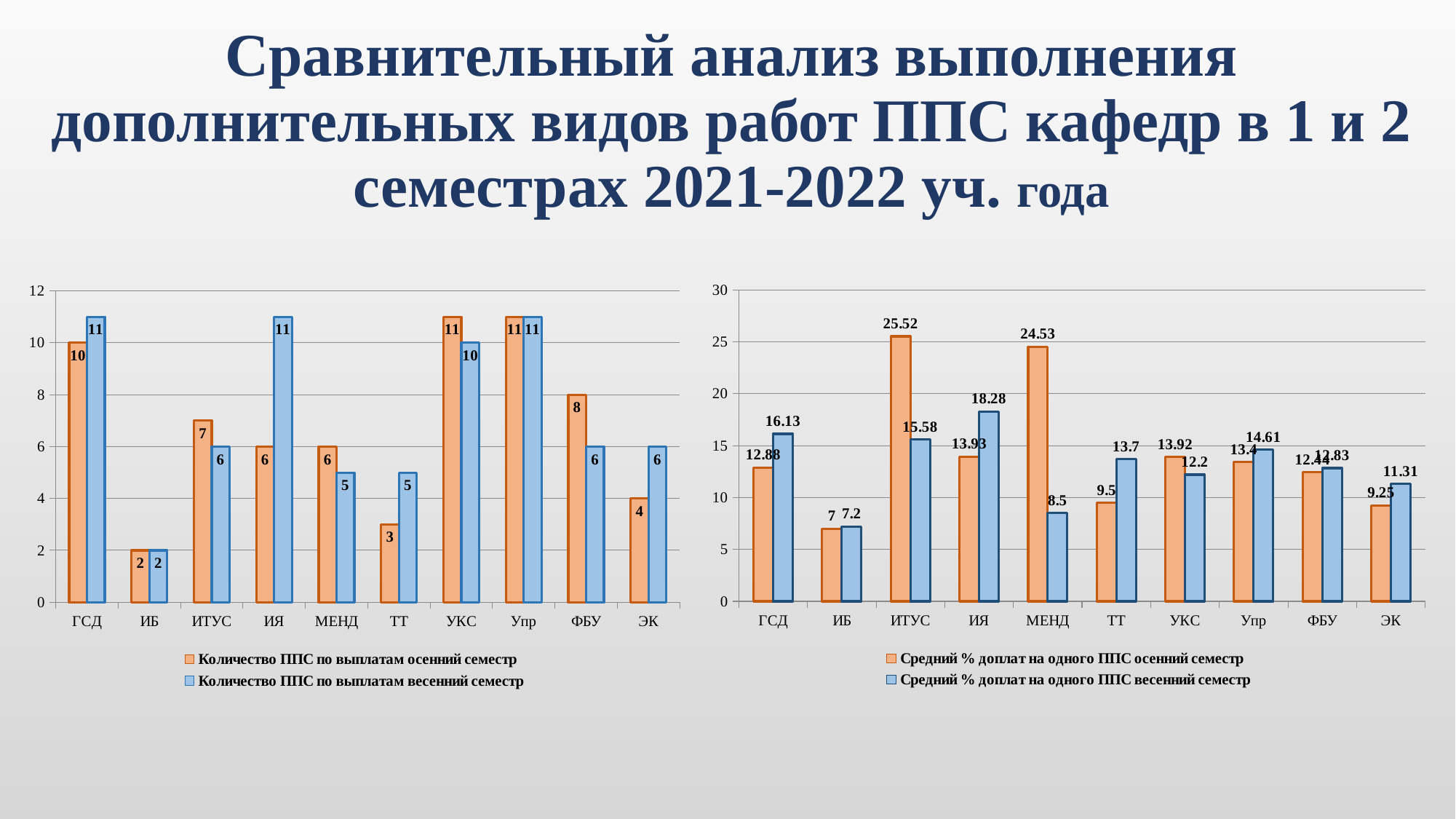
In the right chart, what is the value for МЕНД in the spring semester series (Средний % доплат на одного ППС весенний семестр)? 8.5 In the left chart, which category has the lowest value in the autumn semester series? ИБ In the right chart, which is larger for ГСД: the autumn semester value or the spring semester value? spring semester (16.13) How many series does the legend of the right chart list? 2 In the right chart, which category has the highest value in the autumn semester series? ИТУС In the left chart, what is the value for ТТ in the autumn semester series (Количество ППС по выплатам осенний семестр)? 3 What type of chart is the left chart? bar chart In the right chart, which category has the highest value in the spring semester series? ИЯ In the left chart, what is the difference between the spring and autumn semester values for ИЯ? 5 In the right chart, what is the value for ИТУС in the autumn semester series (Средний % доплат на одного ППС осенний семестр)? 25.52 In the left chart, how many categories are shown on the x axis? 10 In the left chart, what is the value for ИЯ in the spring semester series (Количество ППС по выплатам весенний семестр)? 11